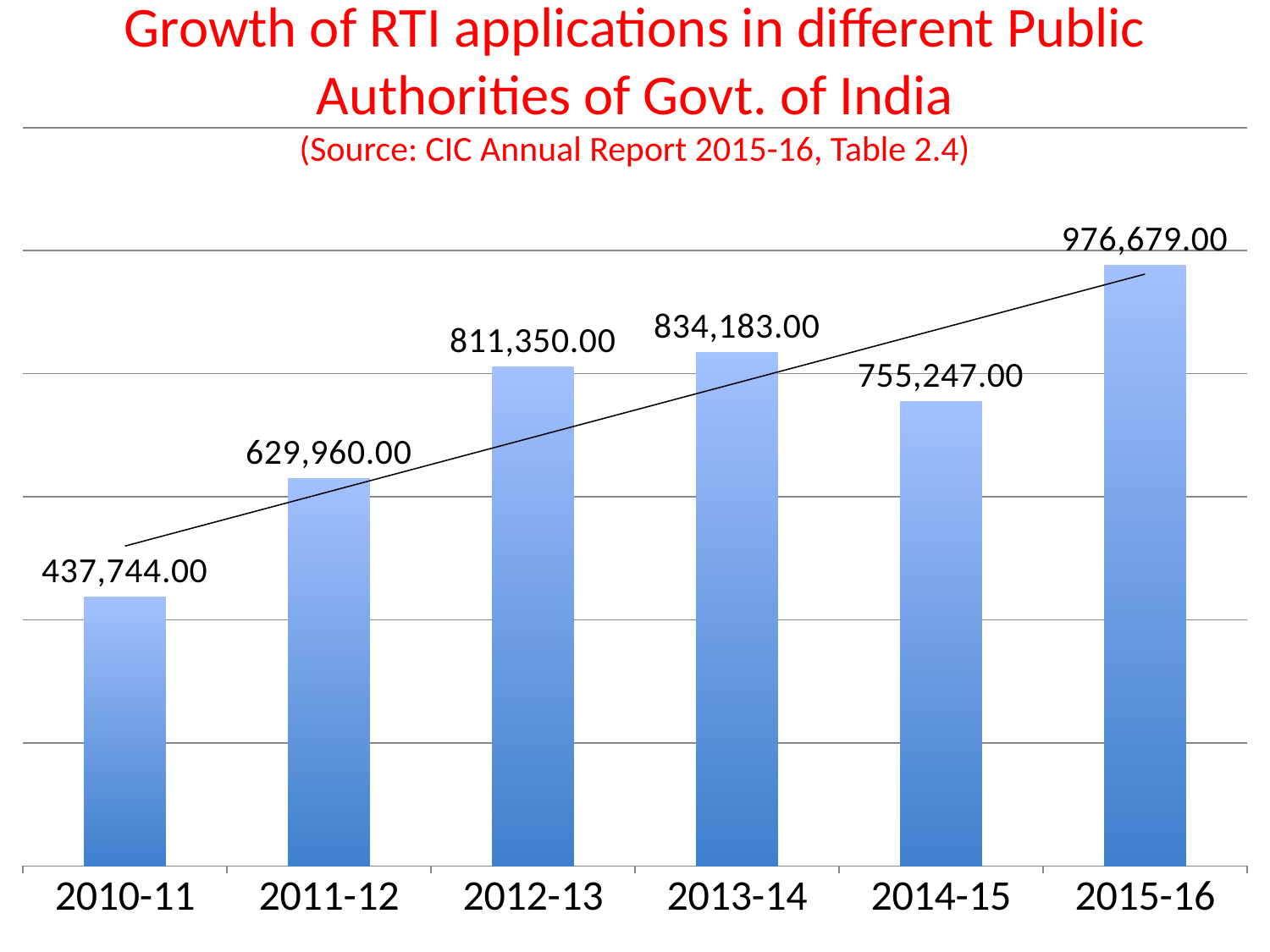
What kind of chart is this? bar chart Which year has the highest value? 2015-16 What source is cited below the chart title? CIC Annual Report 2015-16, Table 2.4 What is the value for 2014-15? 755,247.00 What is the difference between the values for 2015-16 and 2010-11? 538,935.00 What is the difference between the values for 2013-14 and 2014-15? 78,936.00 How many years are shown on the x axis? 6 What is the value for 2010-11? 437,744.00 Which year has the lowest value? 2010-11 Do the values generally rise or fall from 2010-11 to 2015-16? rise Which is larger, the value for 2012-13 or the value for 2014-15? 2012-13 What is the value for 2013-14? 834,183.00